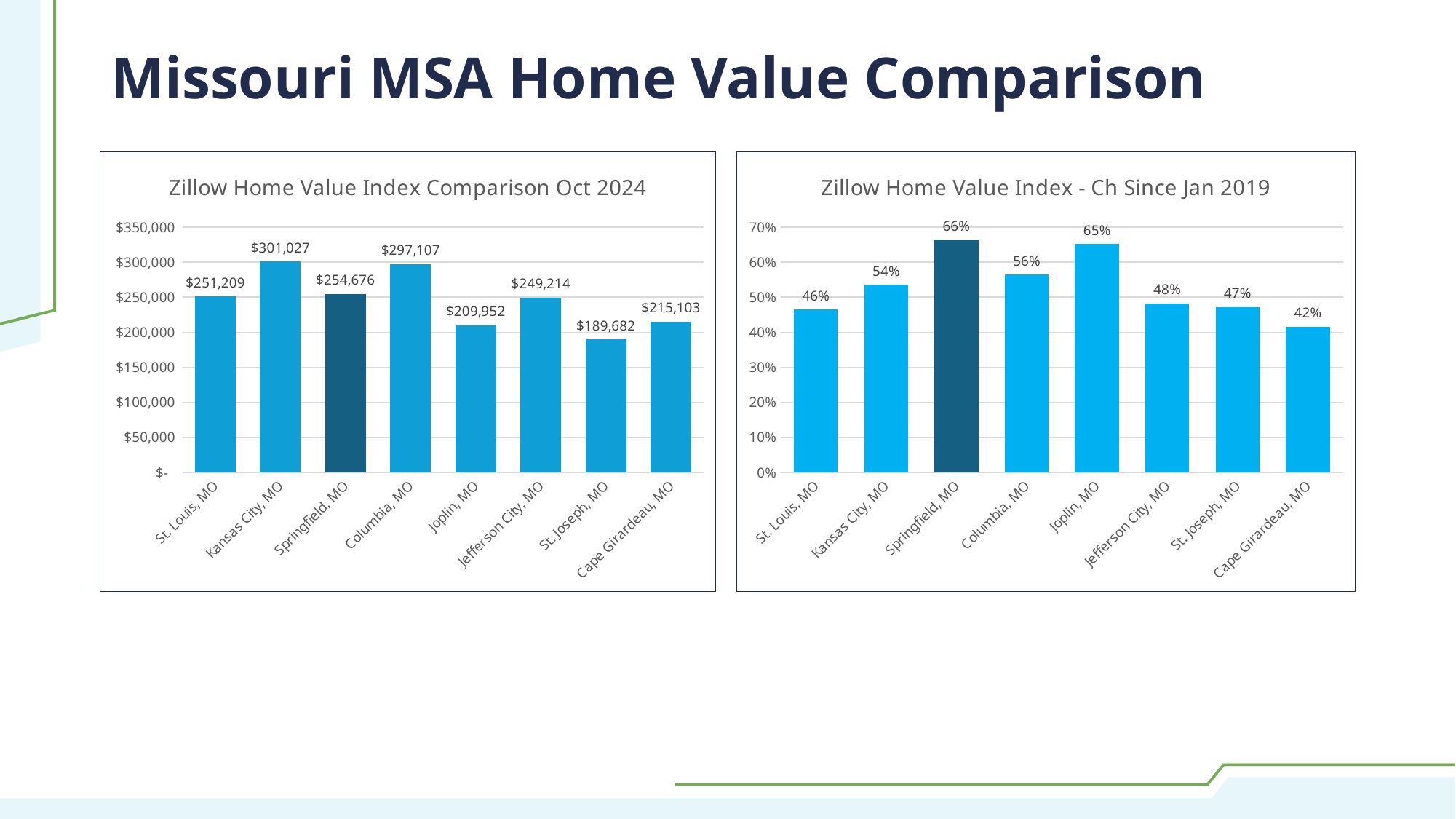
In the 'Zillow Home Value Index - Ch Since Jan 2019' chart, which bar is shown in a darker blue than the others? Springfield, MO In the 'Zillow Home Value Index Comparison Oct 2024' chart, which MSA has the lowest home value? St. Joseph, MO In the 'Zillow Home Value Index Comparison Oct 2024' chart, what is the value for Springfield, MO? $254,676 In the 'Zillow Home Value Index Comparison Oct 2024' chart, what is the difference between the values for Kansas City, MO and Columbia, MO? $3,920 In the 'Zillow Home Value Index - Ch Since Jan 2019' chart, what is the difference between the values for Springfield, MO and St. Louis, MO? 20% In the 'Zillow Home Value Index - Ch Since Jan 2019' chart, which MSA has the highest change? Springfield, MO In the 'Zillow Home Value Index Comparison Oct 2024' chart, which is larger: the value for St. Louis, MO or Jefferson City, MO? St. Louis, MO In the 'Zillow Home Value Index - Ch Since Jan 2019' chart, which MSA has the lowest change? Cape Girardeau, MO What kind of chart is the 'Zillow Home Value Index - Ch Since Jan 2019' chart? Bar chart In the 'Zillow Home Value Index Comparison Oct 2024' chart, how many MSAs are shown? 8 In the 'Zillow Home Value Index - Ch Since Jan 2019' chart, what is the value for Joplin, MO? 65% In the 'Zillow Home Value Index Comparison Oct 2024' chart, which MSA has the highest home value? Kansas City, MO